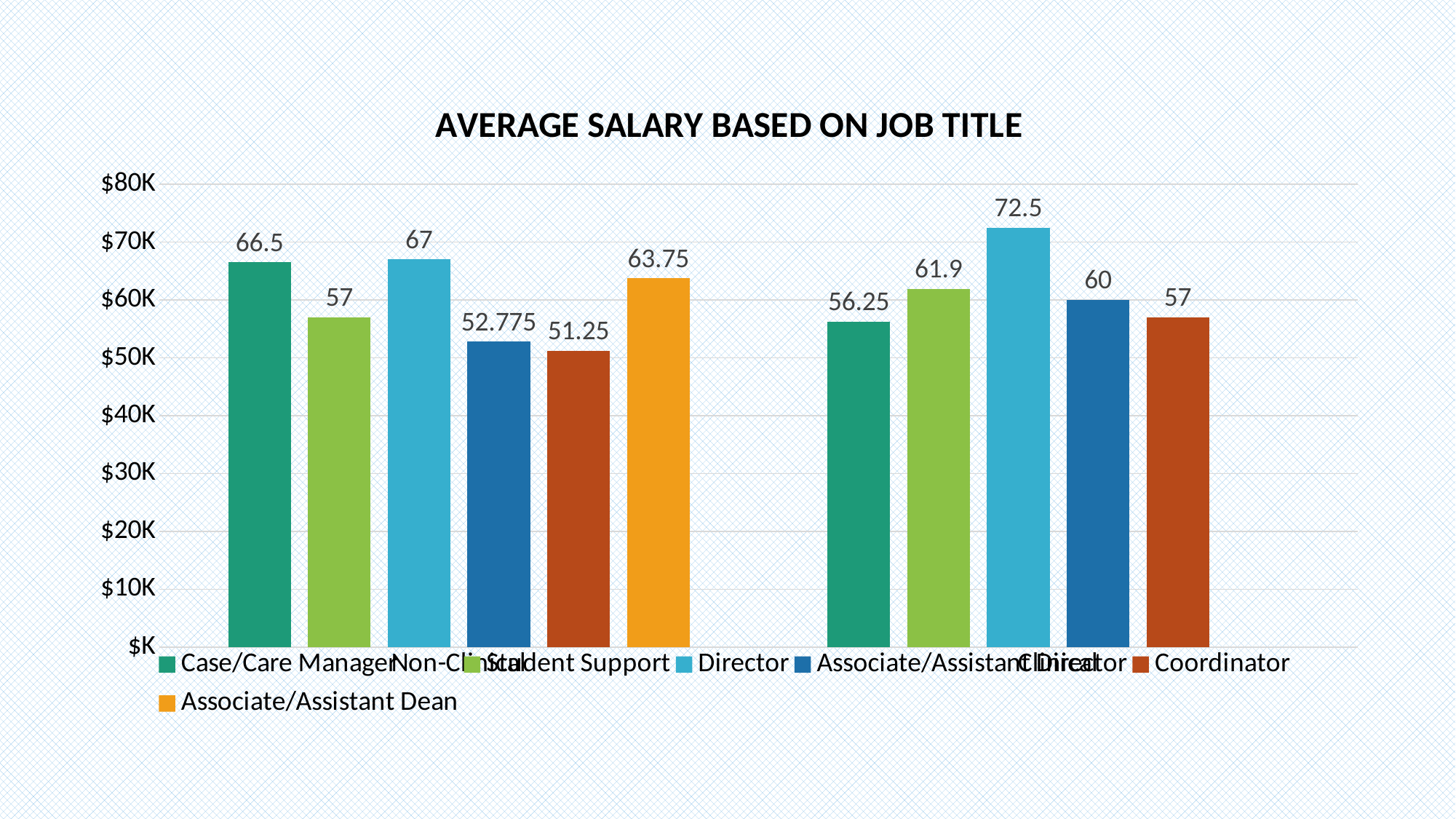
What is the difference between the Director bar in the right-hand group and the Director bar in the left-hand group? 5.5 What is the value of the Director bar in the right-hand group? 72.5 What is the title of the chart? AVERAGE SALARY BASED ON JOB TITLE What is the difference between the Student Support bar in the right-hand group and the Student Support bar in the left-hand group? 4.9 What kind of chart is shown on the slide? bar chart What is the value of the Associate/Assistant Dean bar? 63.75 How many bars are in the right-hand group of the chart? 5 What is the value of the Director bar in the left-hand group? 67 How many series does the legend list? 6 Which series has the lowest bar in the left-hand group? Coordinator Which series has the highest bar in the right-hand group? Director Which is larger: the Case/Care Manager bar in the left-hand group or the Case/Care Manager bar in the right-hand group? the left-hand group